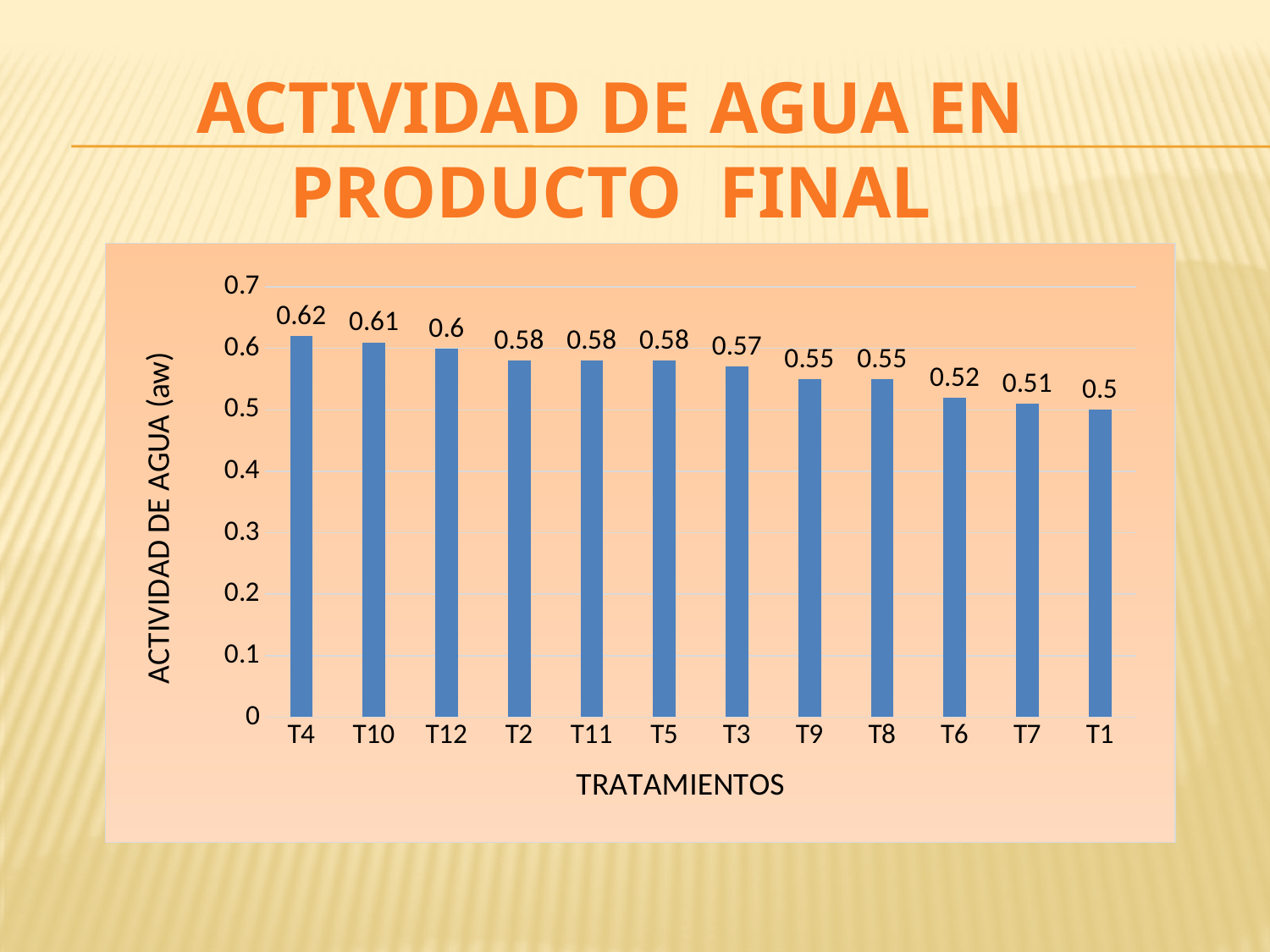
What is the water activity value for treatment T4? 0.62 What is the water activity value for treatment T1? 0.5 What kind of chart is shown on the slide? Bar chart Which treatment has the highest water activity? T4 Which has a higher water activity, T10 or T7? T10 Is the value for T3 greater or less than 0.5? greater Which treatment has the lowest water activity? T1 What is the difference in water activity between T12 and T9? 0.05 What is the difference in water activity between T4 and T1? 0.12 How many treatments are shown on the x axis? 12 What is the water activity value for treatment T6? 0.52 Do the values rise or fall from left to right along the x axis? Fall